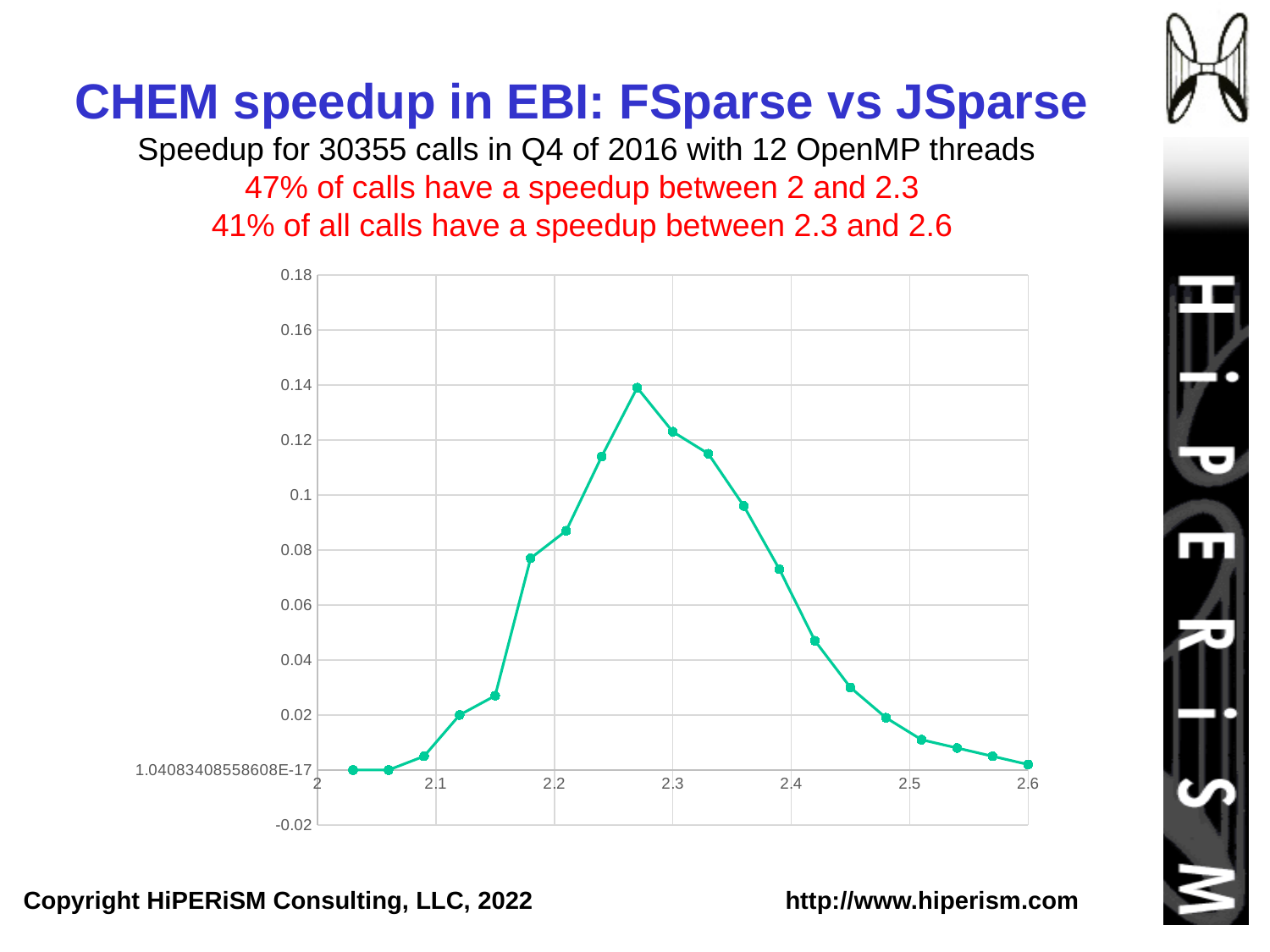
Is the peak value of the line greater or less than 0.16? less Is the peak value of the line greater or less than 0.12? greater What is the title of the slide's chart? CHEM speedup in EBI: FSparse vs JSparse Is the value plotted at a speedup of 2.6 greater or less than 0.02? less Does the line rise or fall as the speedup increases from 2.3 to 2.6? fall What kind of chart is shown on the slide? line chart What is the highest value labelled on the y axis? 0.18 Which is larger, the value plotted at a speedup of 2.3 or at a speedup of 2.6? 2.3 Between which two x-axis ticks does the line reach its highest point? 2.2 and 2.3 Does the line rise or fall as the speedup increases from 2 to 2.2? rise How many OpenMP threads were used for the speedup shown in the chart? 12